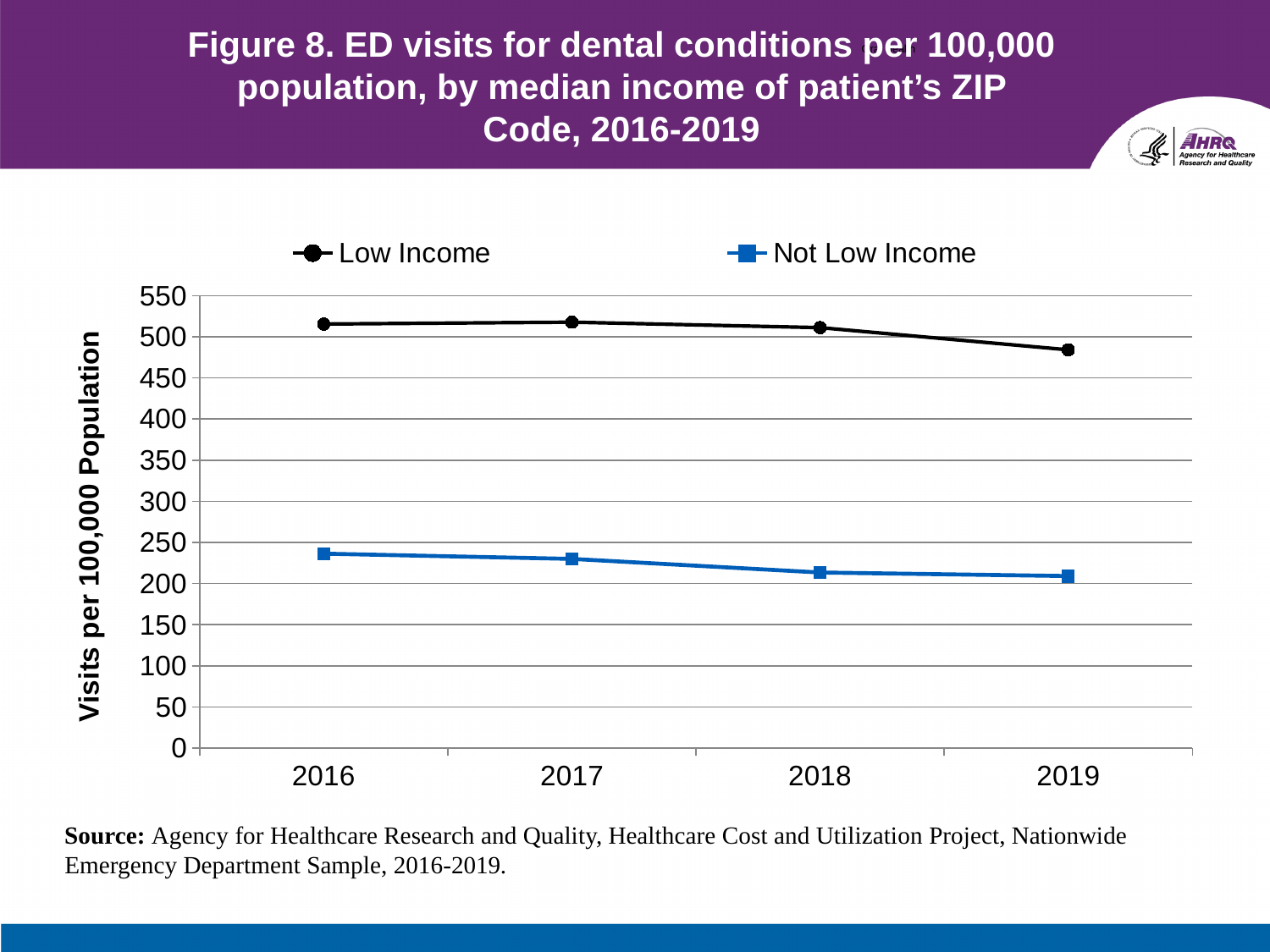
Is the value for Not Low Income in 2016 greater or less than 200? greater How many years are plotted along the x axis? 4 In which year is the Low Income series at its lowest? 2019 Which series has the higher value in 2019, Low Income or Not Low Income? Low Income Is the value for Low Income in 2019 greater or less than 500? less Is the value for Not Low Income in 2018 greater or less than 250? less In which year is the Not Low Income series at its highest? 2016 Does the Not Low Income series rise or fall from 2016 to 2019? fall What kind of chart is shown on the slide? line chart What is the label on the y axis? Visits per 100,000 Population How many series does the legend list? 2